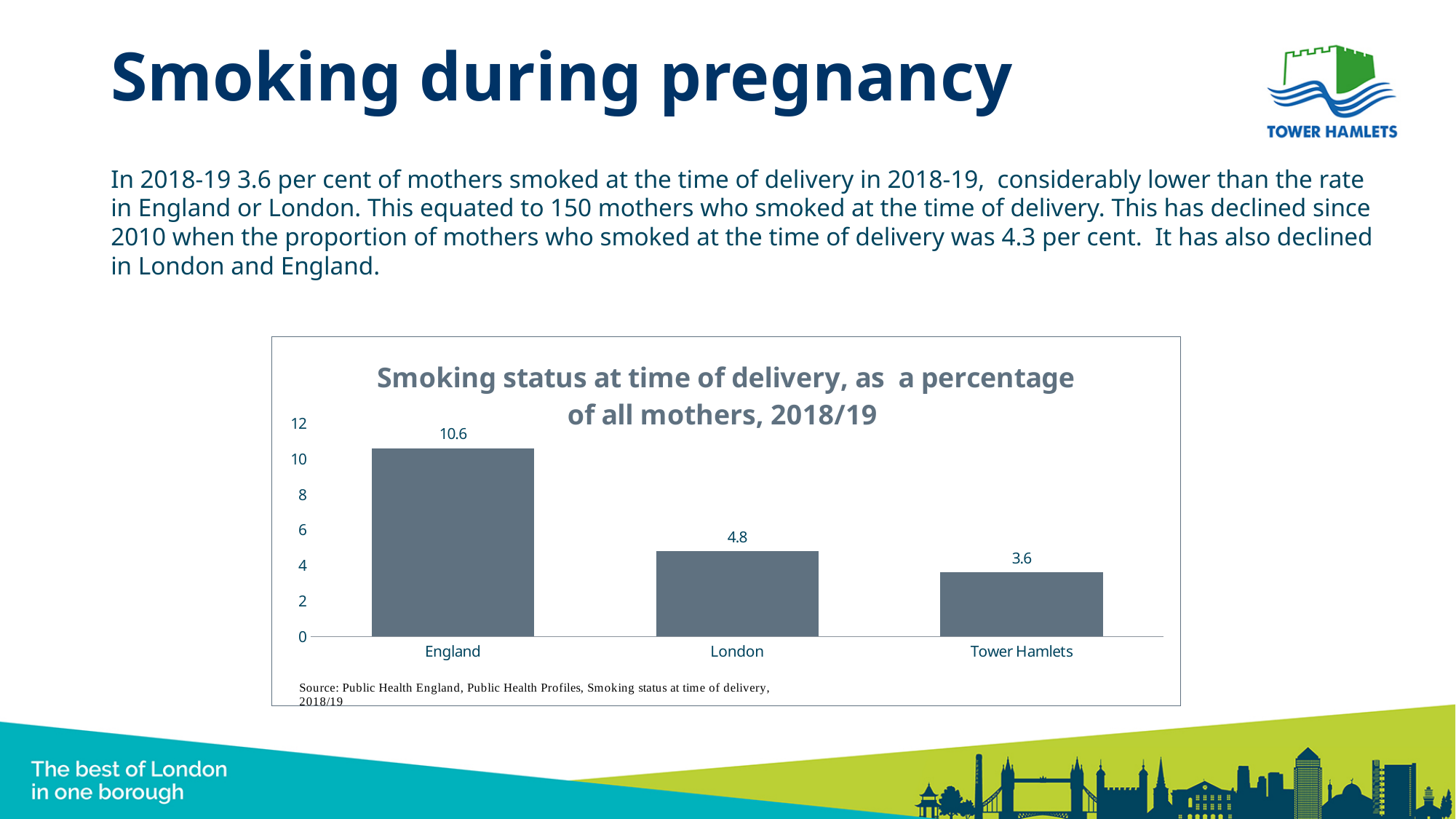
What is the value for England in the chart? 10.6 What kind of chart is shown on the slide? Bar chart What is the value for London in the chart? 4.8 Which has a larger value, London or Tower Hamlets? London What is the value for Tower Hamlets in the chart? 3.6 Which category has the lowest value in the chart? Tower Hamlets What is the difference between the values for England and Tower Hamlets? 7.0 How many categories are shown in the chart? 3 What is the difference between the values for London and Tower Hamlets? 1.2 Which category has the highest value in the chart? England Is the value for England greater or less than 10? greater What is the title of the chart? Smoking status at time of delivery, as a percentage of all mothers, 2018/19